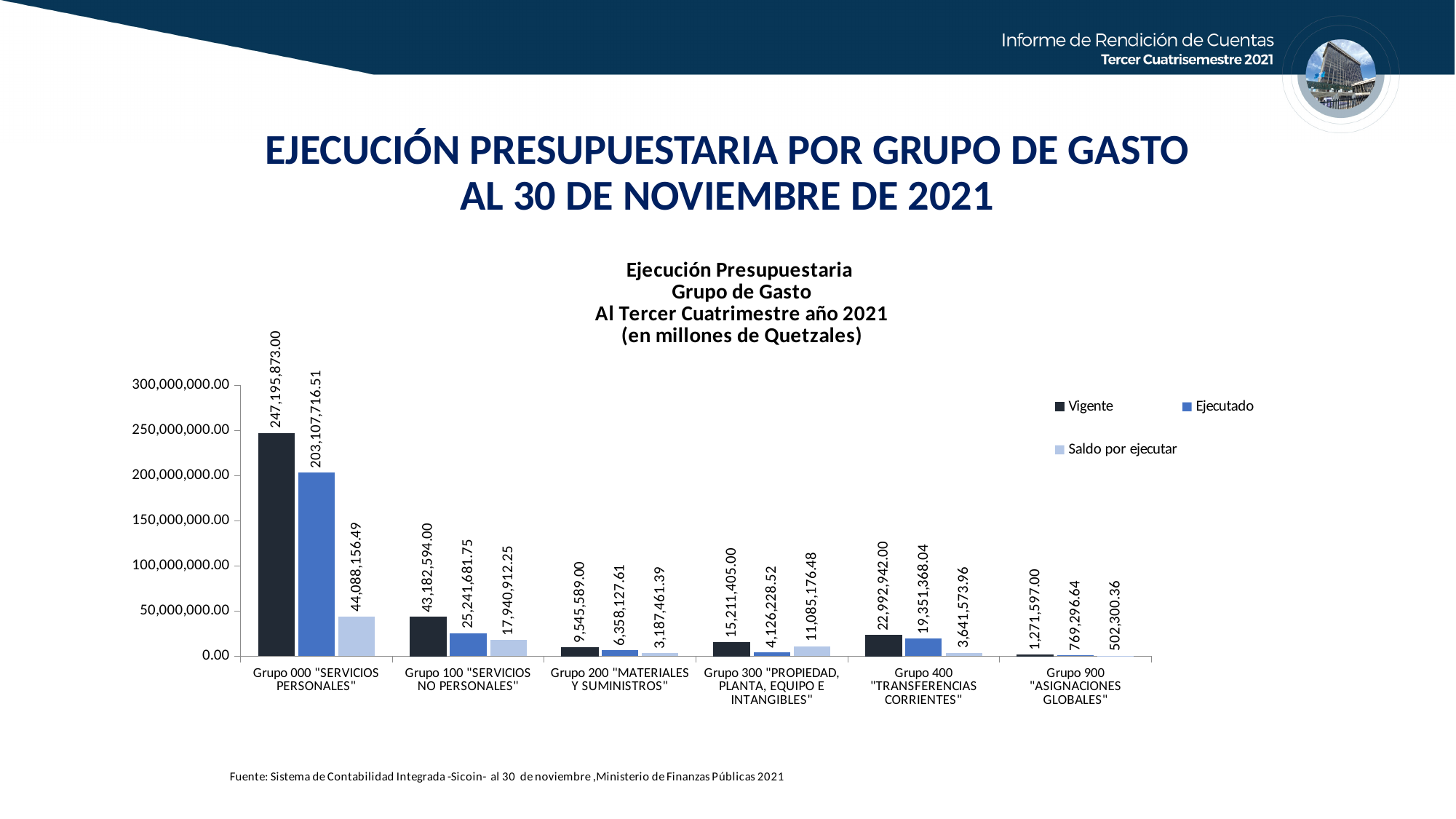
What is the Ejecutado value for Grupo 900 "ASIGNACIONES GLOBALES"? 769,296.64 How many series does the chart legend list? 3 What type of chart is shown on the slide? bar chart What is the Saldo por ejecutar value for Grupo 300 "PROPIEDAD, PLANTA, EQUIPO E INTANGIBLES"? 11,085,176.48 For Grupo 300 "PROPIEDAD, PLANTA, EQUIPO E INTANGIBLES", which is larger: Ejecutado or Saldo por ejecutar? Saldo por ejecutar Which group has the lowest Ejecutado value? Grupo 900 "ASIGNACIONES GLOBALES" What is the difference between the Vigente and Ejecutado values for Grupo 400 "TRANSFERENCIAS CORRIENTES"? 3,641,573.96 Is the Ejecutado value for Grupo 000 "SERVICIOS PERSONALES" greater or less than 200,000,000.00? greater Which group has the highest Vigente value? Grupo 000 "SERVICIOS PERSONALES" What is the Vigente value for Grupo 000 "SERVICIOS PERSONALES"? 247,195,873.00 What is the Ejecutado value for Grupo 100 "SERVICIOS NO PERSONALES"? 25,241,681.75 How many expense groups (categories) are shown on the x axis? 6